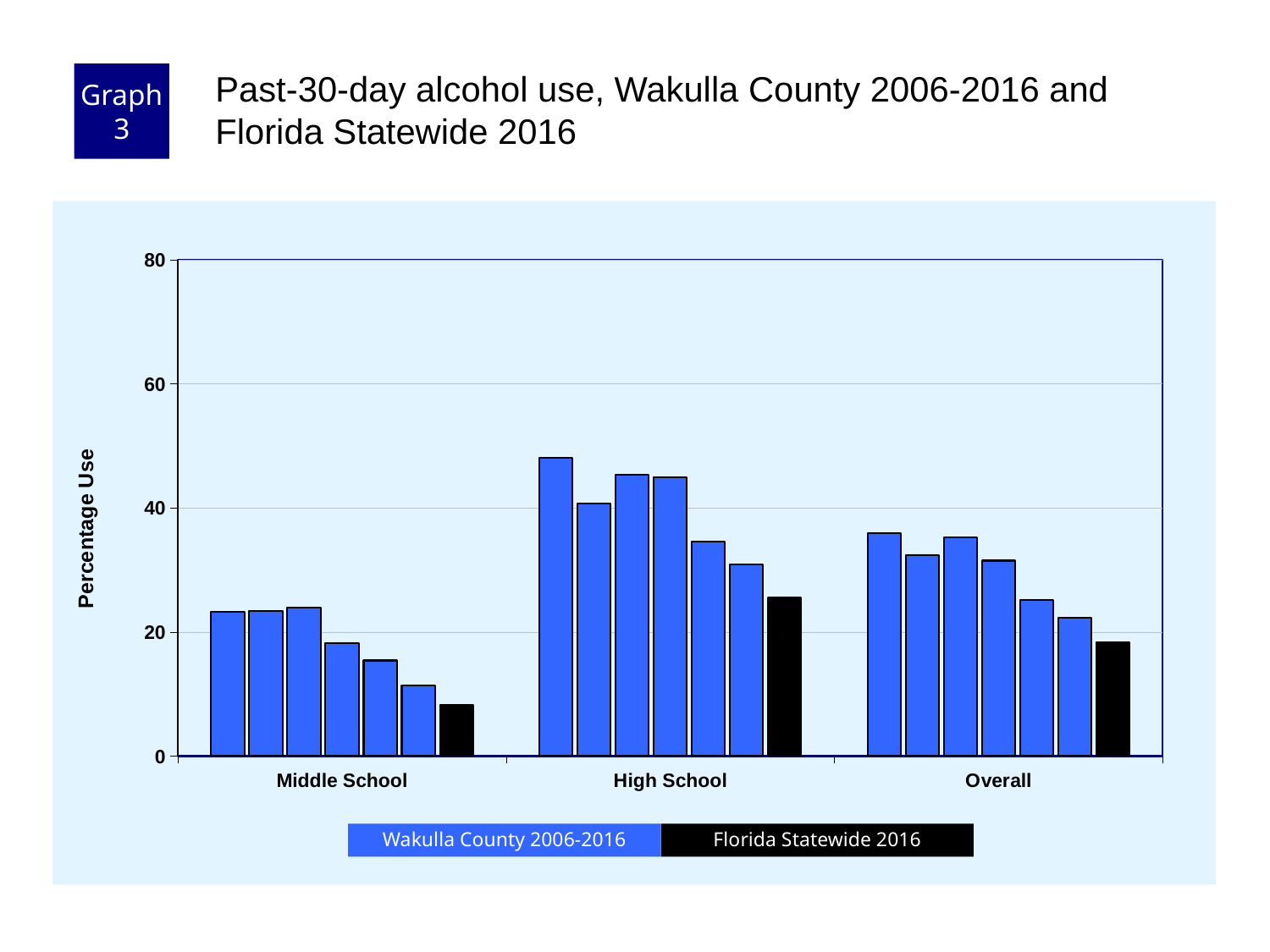
Which series is shown in black? Florida Statewide 2016 Is the tallest Wakulla County bar for High School greater or less than 40? greater Which category has the highest bars overall? High School Is the tallest Wakulla County bar for Overall greater or less than 40? less Which is larger, the Florida Statewide 2016 value for High School or for Overall? High School How many series does the legend list? 2 Is the Florida Statewide 2016 value for Middle School greater or less than 20? less What kind of chart is shown on the slide? bar chart Which category has the lowest Florida Statewide 2016 bar? Middle School How many categories are shown on the x axis? 3 What is the label of the y axis? Percentage Use